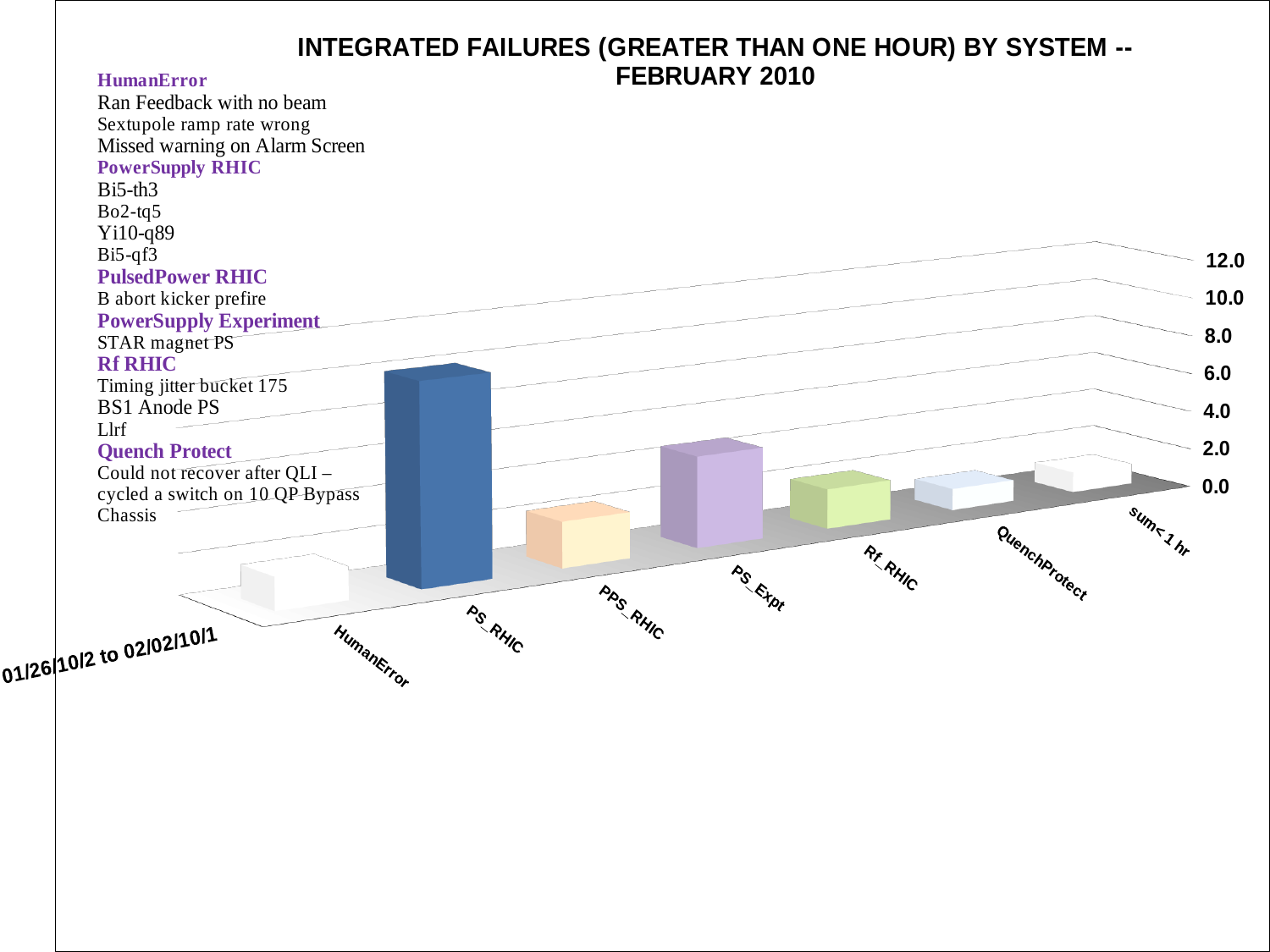
Is the value for PPS_RHIC greater or less than 4.0? less Is the value for PS_Expt greater or less than 2.0? greater What kind of chart is shown on the slide? bar chart Which system has the highest integrated failures in the chart? PS_RHIC What is the title of the chart? INTEGRATED FAILURES (GREATER THAN ONE HOUR) BY SYSTEM -- FEBRUARY 2010 Which is larger, the value for PS_Expt or the value for Rf_RHIC? PS_Expt Which is larger, the value for PS_Expt or the value for PPS_RHIC? PS_Expt How many system categories are plotted along the x axis of the chart? 7 Which is larger, the value for PS_RHIC or the value for PS_Expt? PS_RHIC Is the value for PS_RHIC greater or less than 6.0? greater What colour is the bar for PS_RHIC? blue